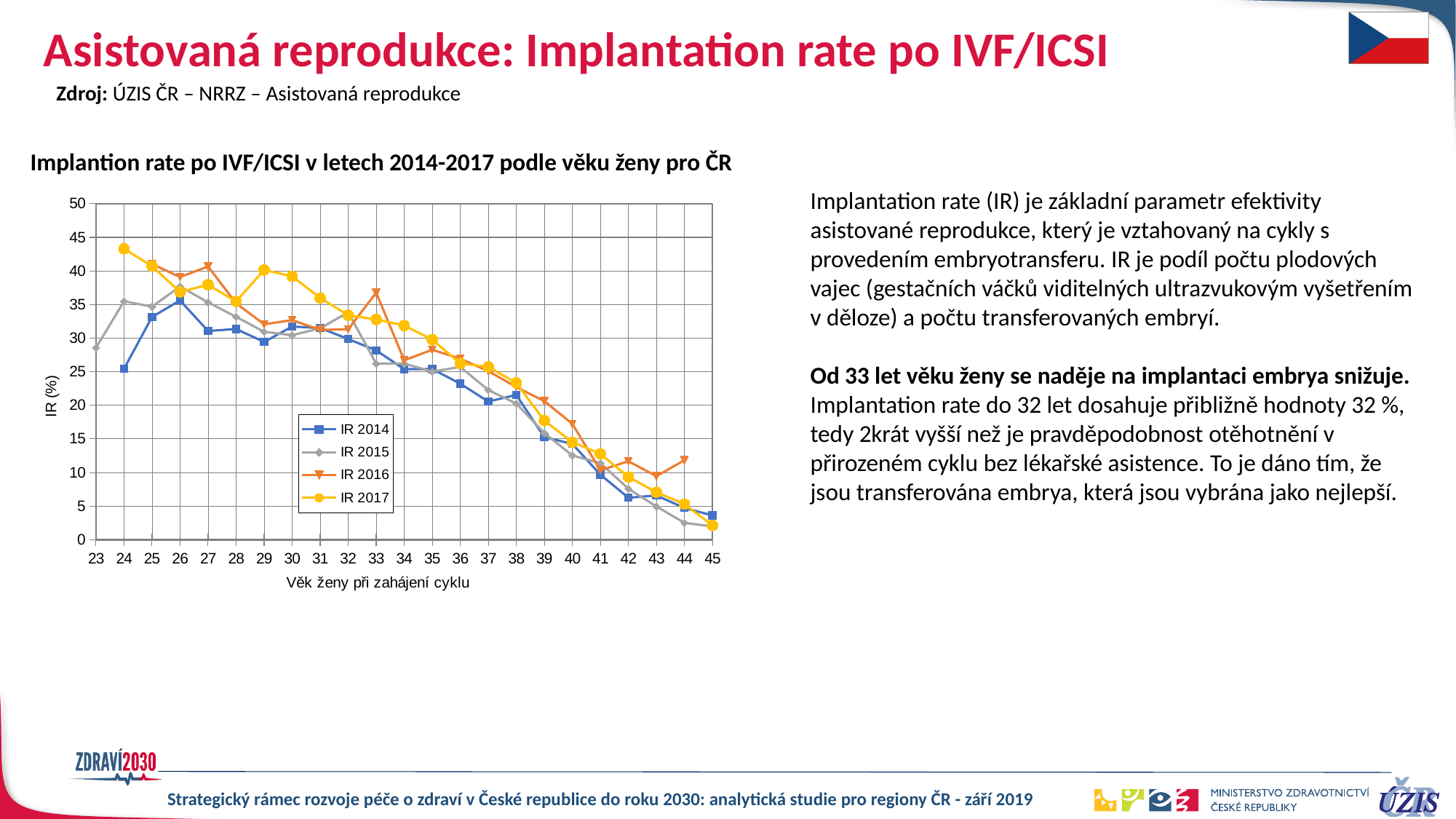
How many age categories are shown on the x axis of the chart? 23 At which age does the IR 2017 series reach its highest value? 24 Is the IR 2016 value at age 44 greater or less than 10? greater Overall, do the implantation rate values rise or fall as the woman's age increases along the x axis? fall At age 24, which series has the larger value: IR 2014 or IR 2017? IR 2017 What kind of chart is shown on the slide? line chart How many series does the chart legend list? 4 Is the IR 2014 value at age 45 greater or less than 5? less Is the IR 2014 value at age 24 greater or less than 30? less What is the label of the x axis of the chart? Věk ženy při zahájení cyklu